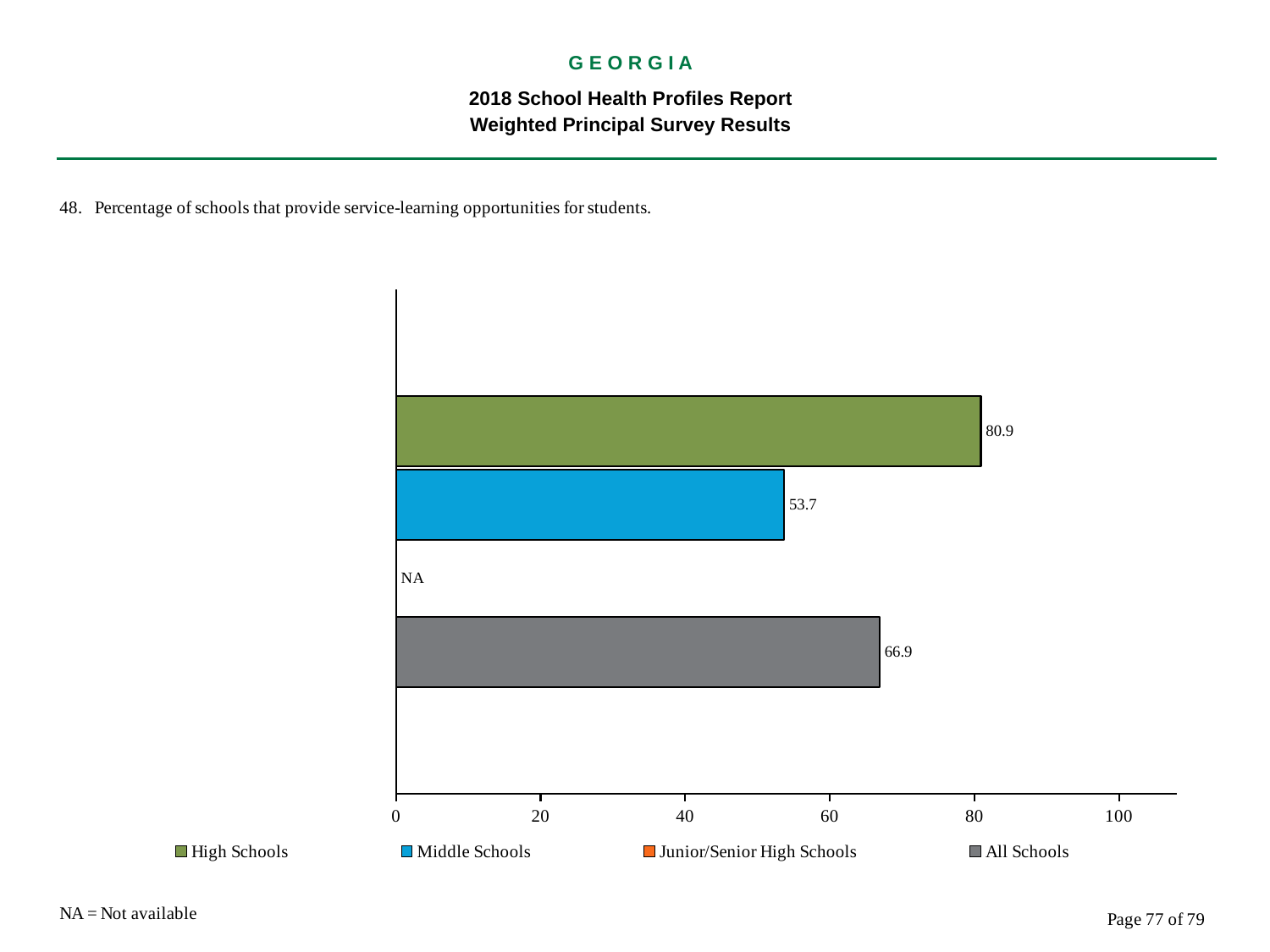
What is the difference between the High Schools value and the Middle Schools value? 27.2 How many series does the legend list? 4 What is shown for Junior/Senior High Schools? NA What does NA stand for according to the note on the slide? Not available Which is larger, the value for All Schools or the value for Middle Schools? All Schools What is the value for All Schools? 66.9 Which school type with a plotted value has the lowest value? Middle Schools What is the value for High Schools? 80.9 Is the value for All Schools greater or less than 60? greater What is the value for Middle Schools? 53.7 Which school type has the highest value? High Schools What kind of chart is this? bar chart